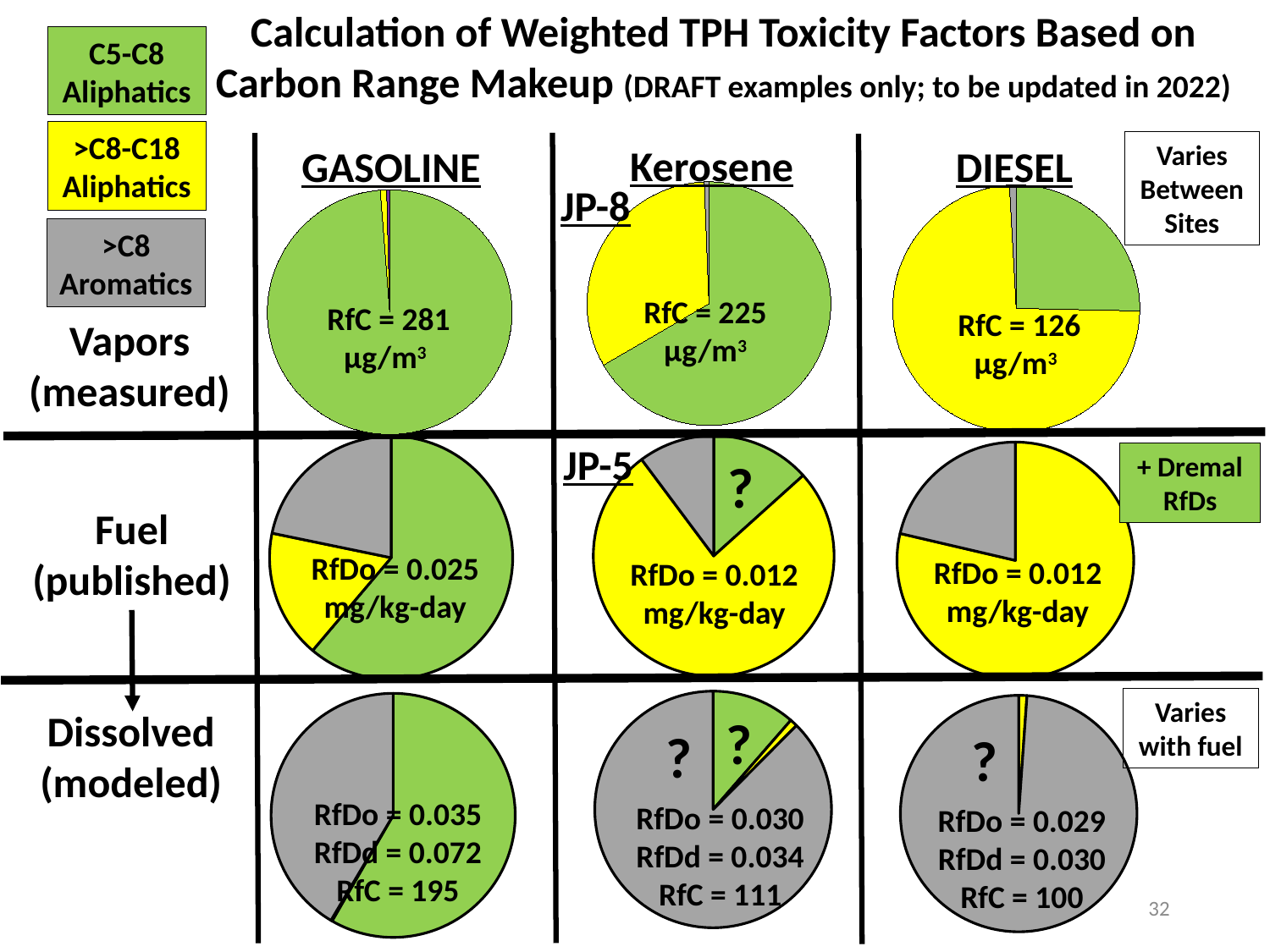
In the Dissolved (modeled) row, which fuel's pie chart shows the lowest RfC value? Diesel What RfC value is printed on the Gasoline pie chart in the Vapors (measured) row? 281 µg/m³ According to the legend, which colour represents >C8 Aromatics? grey What type of chart is used throughout the grid on this slide? pie chart How many pie charts are shown on the slide? 9 In the Vapors (measured) row, which fuel's pie chart shows the highest RfC value? Gasoline What is the difference between the RfC values printed on the Gasoline and Diesel pie charts in the Vapors (measured) row? 155 µg/m³ In the Fuel (published) row, is the RfDo value for Gasoline larger or smaller than the RfDo value for Kerosene/JP-5? larger What RfDo value is printed on the Diesel pie chart in the Fuel (published) row? 0.012 mg/kg-day In the Diesel pie chart of the Vapors (measured) row, which carbon range category takes the largest share? >C8-C18 Aliphatics What RfC value is printed on the Kerosene/JP-8 pie chart in the Dissolved (modeled) row? 111 What is the difference between the RfC values printed on the Gasoline and Diesel pie charts in the Dissolved (modeled) row? 95